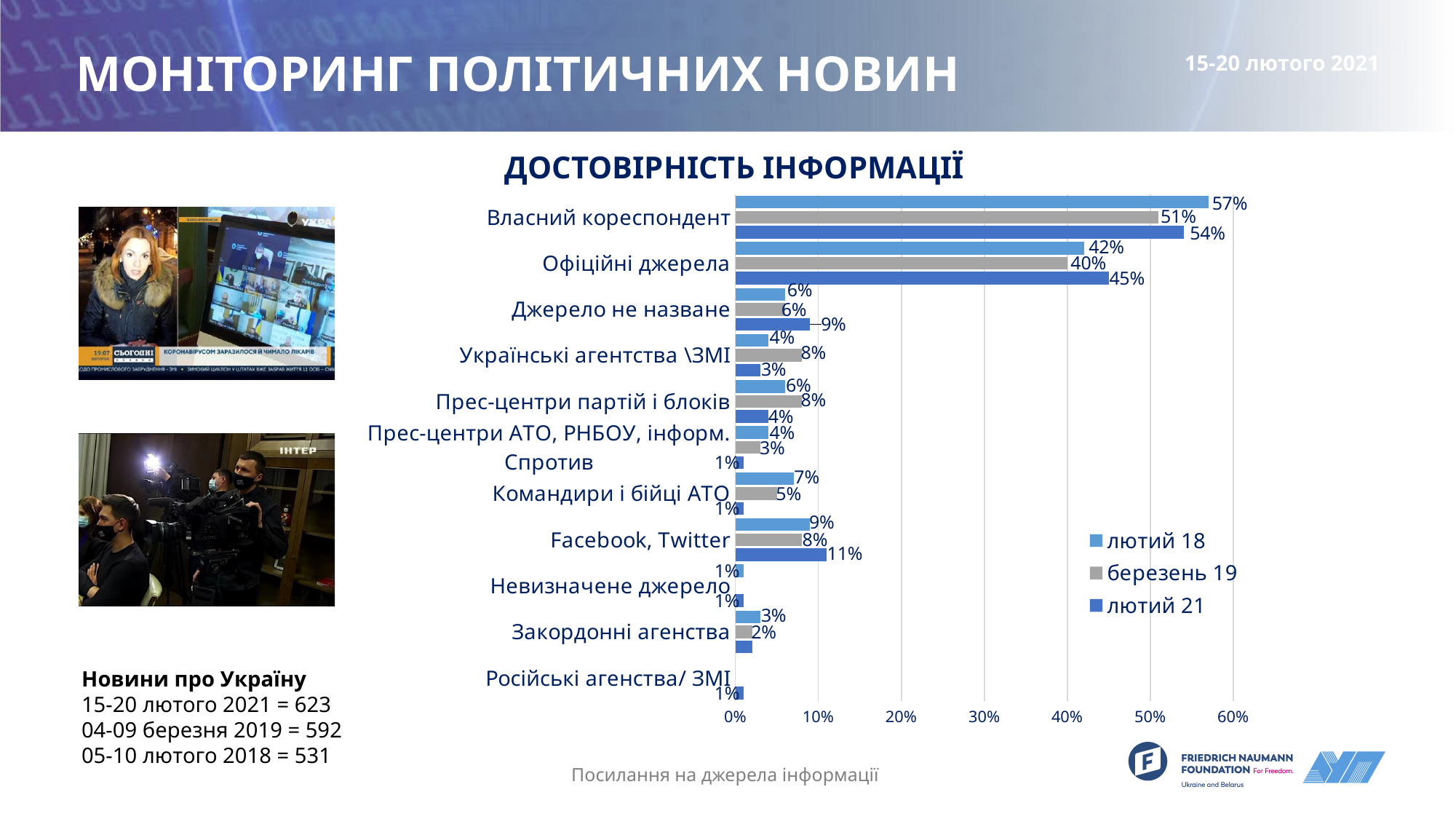
How many categories are shown on the chart? 11 What is the value for Власний кореспондент in the лютий 18 series? 57% How many series does the legend list? 3 What is the title of the chart? ДОСТОВІРНІСТЬ ІНФОРМАЦІЇ Which is larger for Джерело не назване: the лютий 21 value or the лютий 18 value? лютий 21 What is the value for Офіційні джерела in the лютий 21 series? 45% What is the difference between the лютий 18 and березень 19 values for Власний кореспондент? 6% Is the лютий 21 value for Офіційні джерела greater or less than 40%? greater Which category has the highest value in the лютий 21 series? Власний кореспондент What kind of chart is shown on the slide? Bar chart Which series is shown in grey in the legend? березень 19 What is the value for Facebook, Twitter in the березень 19 series? 8%